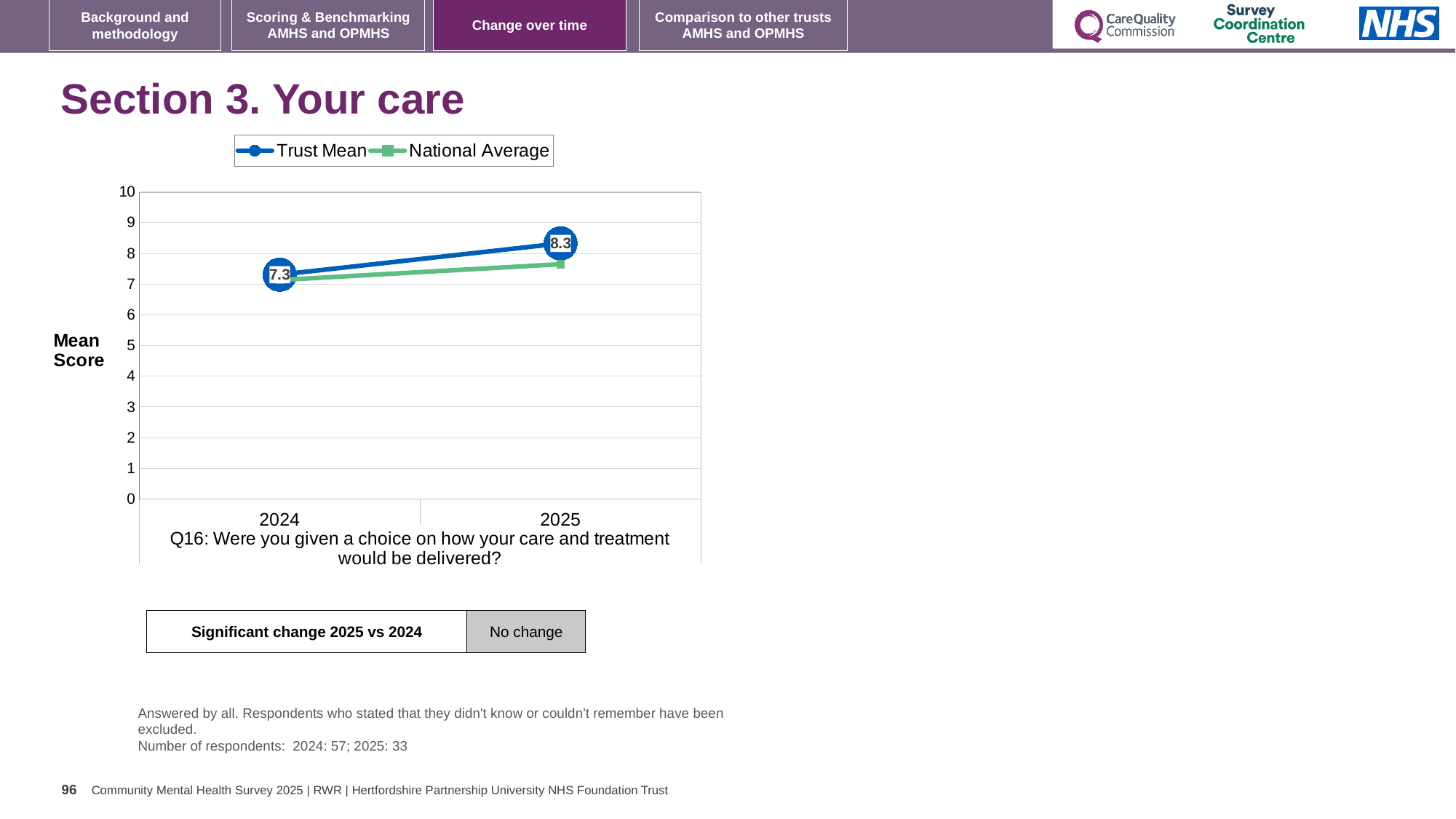
What is the Trust Mean score for 2025? 8.3 Which year has the higher Trust Mean score, 2024 or 2025? 2025 What is the label on the y axis of the chart? Mean Score What is the Trust Mean score for 2024? 7.3 In 2025, which series has the higher value, Trust Mean or National Average? Trust Mean By how much did the Trust Mean score change from 2024 to 2025? 1.0 How many years are plotted on the x axis of the chart? 2 How many series does the chart legend list? 2 Does the Trust Mean score rise or fall from 2024 to 2025? Rise Is the National Average value for 2024 greater or less than 8? less What type of chart is shown on the slide? Line chart Is the National Average value for 2025 greater or less than 7? greater